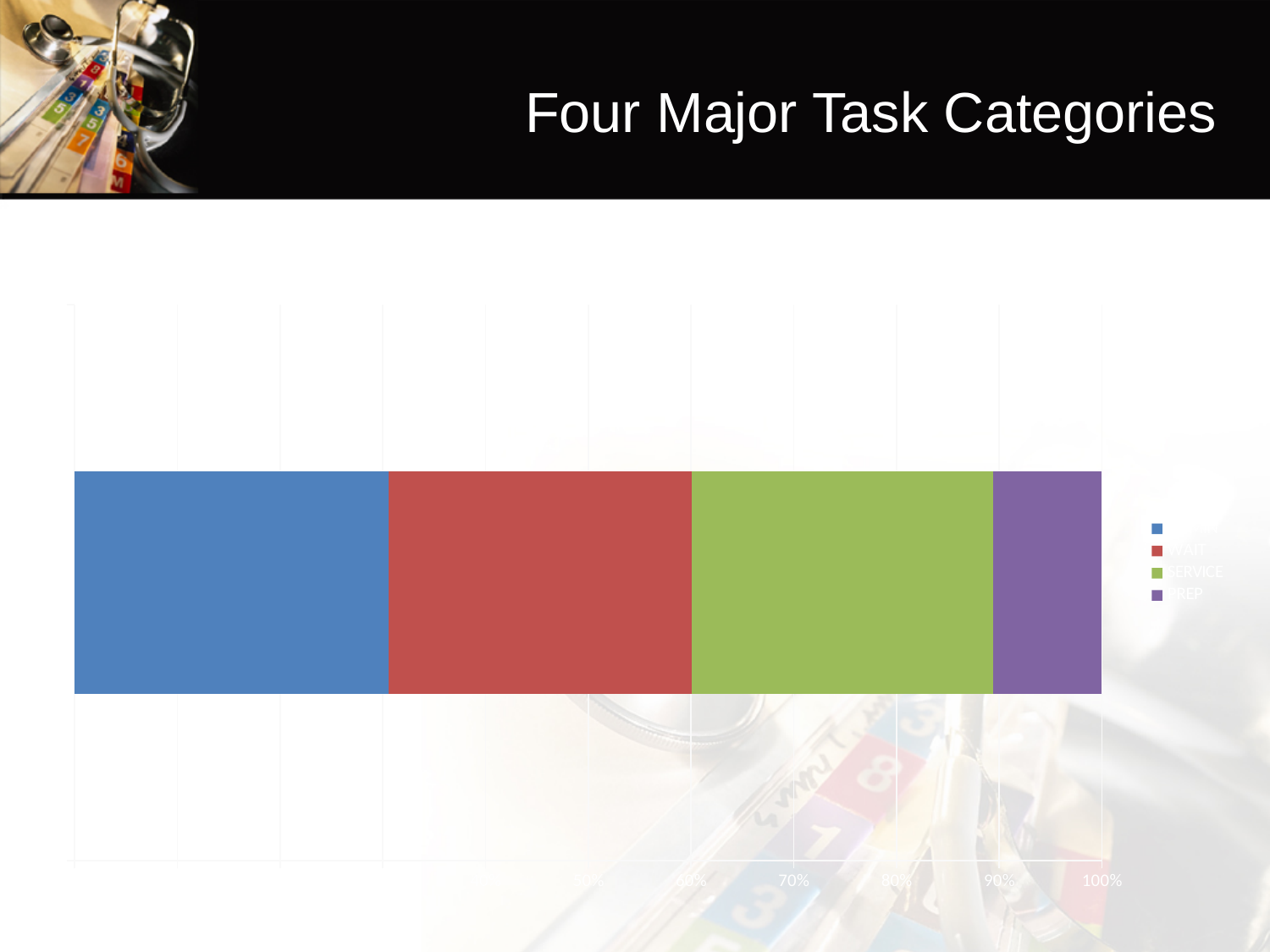
How many series does the legend list? 4 Is the value of the PREP (purple) segment greater or less than 50%? less What kind of chart is shown on the slide? stacked bar chart Which is larger, the blue segment or the purple (PREP) segment? the blue segment What is the highest percentage tick shown on the horizontal axis? 100% What is the title of the slide containing the chart? Four Major Task Categories Which is larger, the WAIT (red) segment or the PREP (purple) segment? WAIT Which colour represents the SERVICE series in the legend? green Does the stacked bar extend all the way to the 100% tick on the axis? yes How many coloured segments make up the stacked bar? 4 Which segment of the stacked bar is the smallest? the purple segment (PREP)